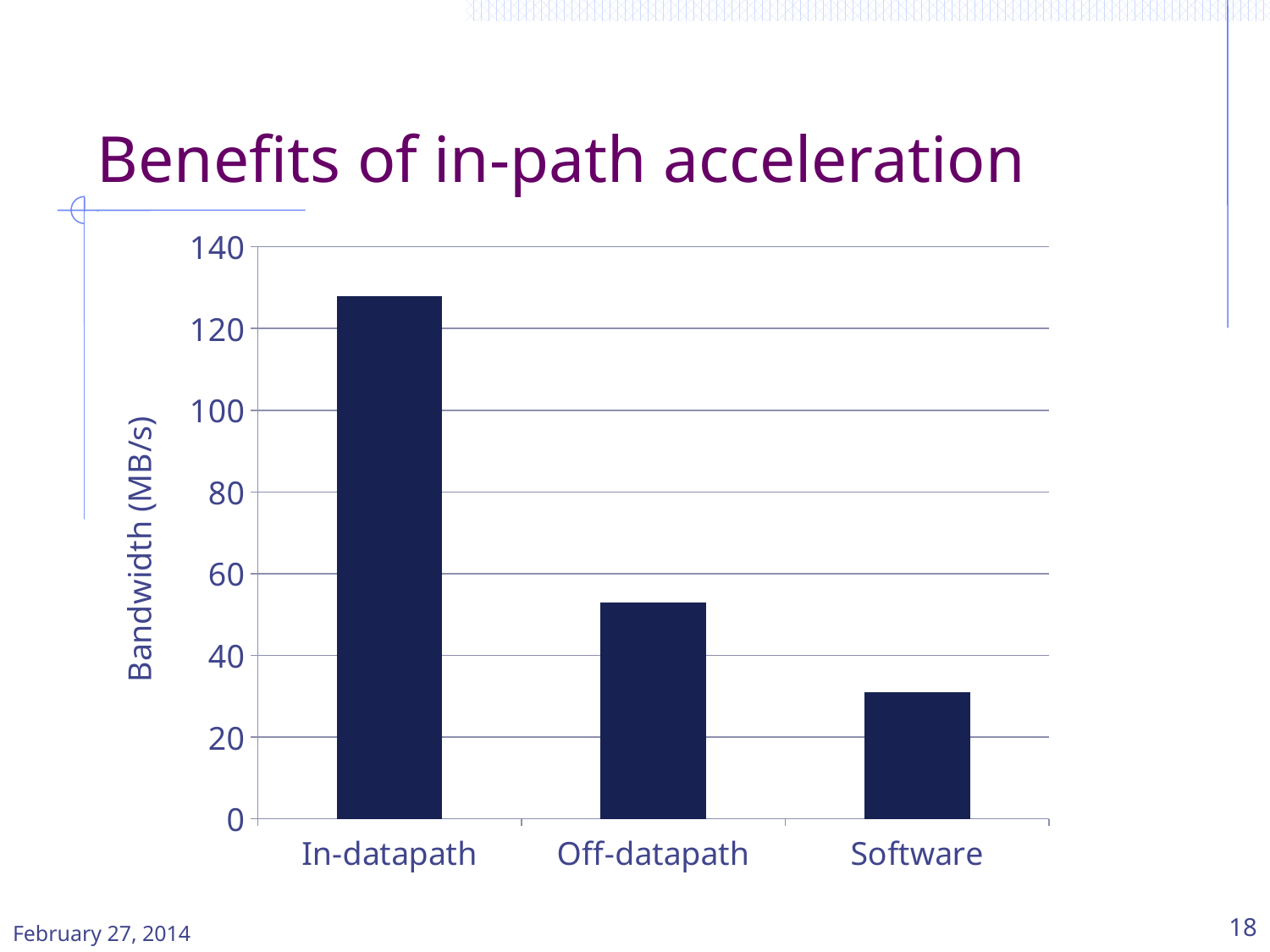
Is the value for Off-datapath greater or less than 60? less Is the value for In-datapath greater or less than 120? greater What is the title of the slide containing the chart? Benefits of in-path acceleration Which category has the lowest bandwidth? Software Is the value for Off-datapath greater or less than 40? greater What kind of chart is shown on the slide? bar chart Which is larger, the bandwidth for Off-datapath or for Software? Off-datapath Which category has the highest bandwidth? In-datapath Do the values rise or fall from left to right across the categories? fall How many categories are plotted on the chart? 3 What is the label of the vertical axis? Bandwidth (MB/s)